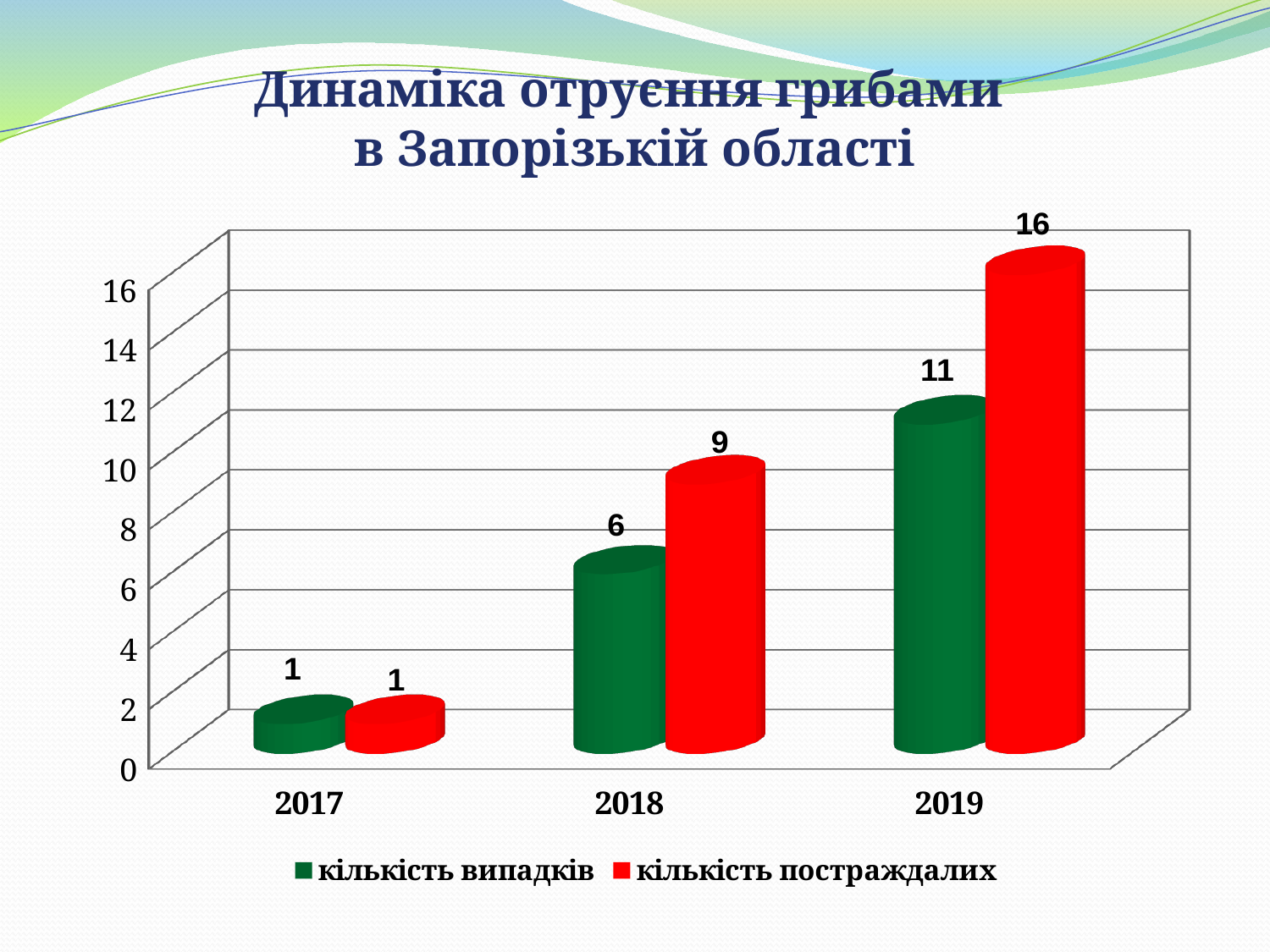
Do the values for 'кількість постраждалих' rise or fall from 2017 to 2019? rise What kind of chart is shown on the slide? bar chart What colour are the bars for 'кількість постраждалих'? red How many years are shown on the x axis? 3 Which year has the lowest value for 'кількість випадків'? 2017 What is the value of 'кількість випадків' for 2017? 1 How many series does the legend list? 2 What is the value of 'кількість постраждалих' for 2019? 16 Which is larger in 2018: 'кількість випадків' or 'кількість постраждалих'? кількість постраждалих What is the difference between 'кількість постраждалих' and 'кількість випадків' in 2019? 5 What is the value of 'кількість випадків' for 2018? 6 Which year has the highest value for 'кількість постраждалих'? 2019